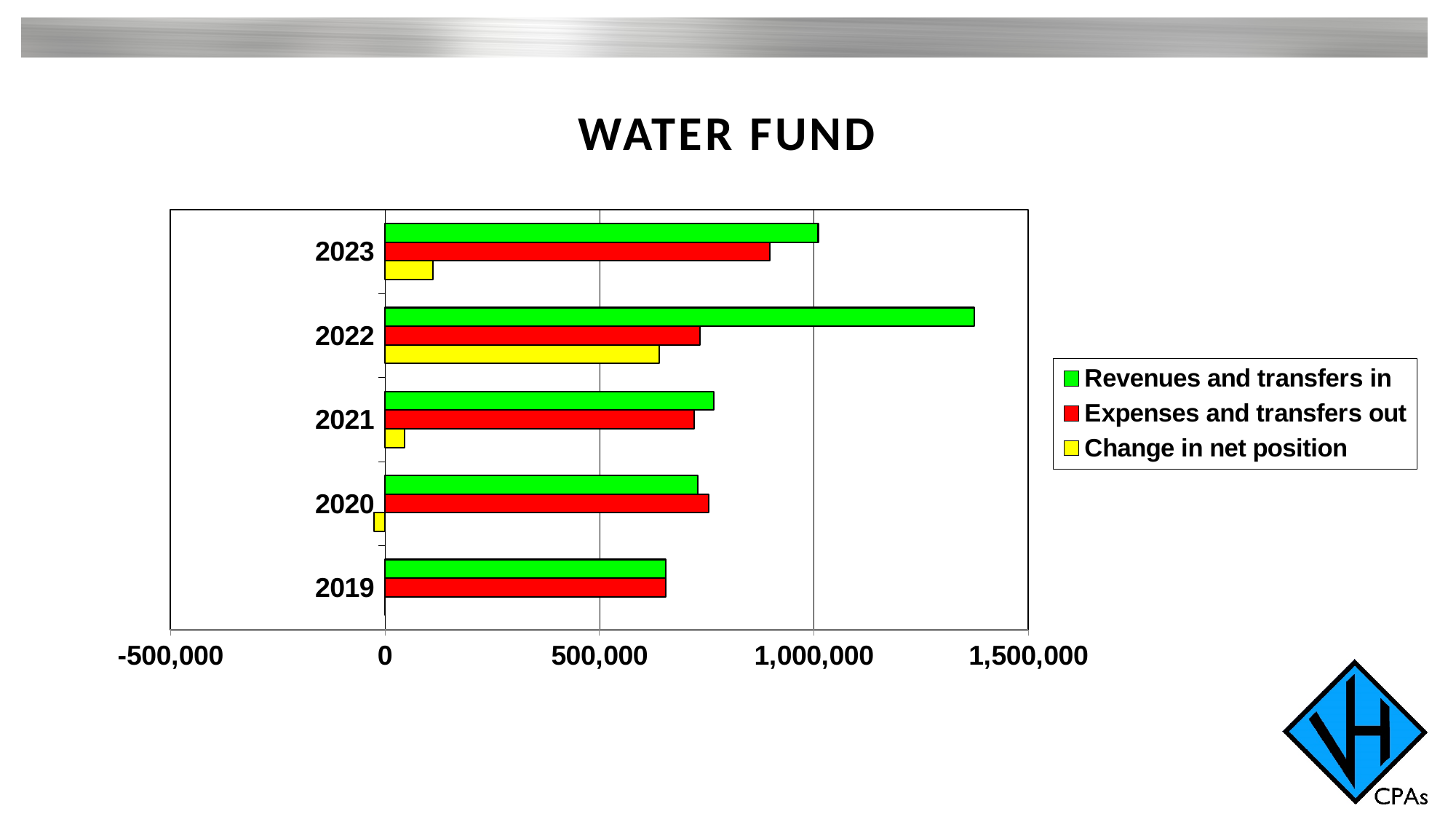
Which year has the highest value for Revenues and transfers in? 2022 Is the value for Expenses and transfers out for 2023 greater or less than 1,000,000? less How many years are shown on the chart? 5 Which year shows a negative Change in net position? 2020 In 2022, which is larger: Revenues and transfers in or Expenses and transfers out? Revenues and transfers in Is the value for Revenues and transfers in for 2022 greater or less than 1,000,000? greater What is the title of the chart? WATER FUND Which year has the highest value for Expenses and transfers out? 2023 Is the value for Change in net position for 2022 greater or less than 500,000? greater How many series does the legend list? 3 Which year has the lowest value for Revenues and transfers in? 2019 What kind of chart is shown on the slide? bar chart